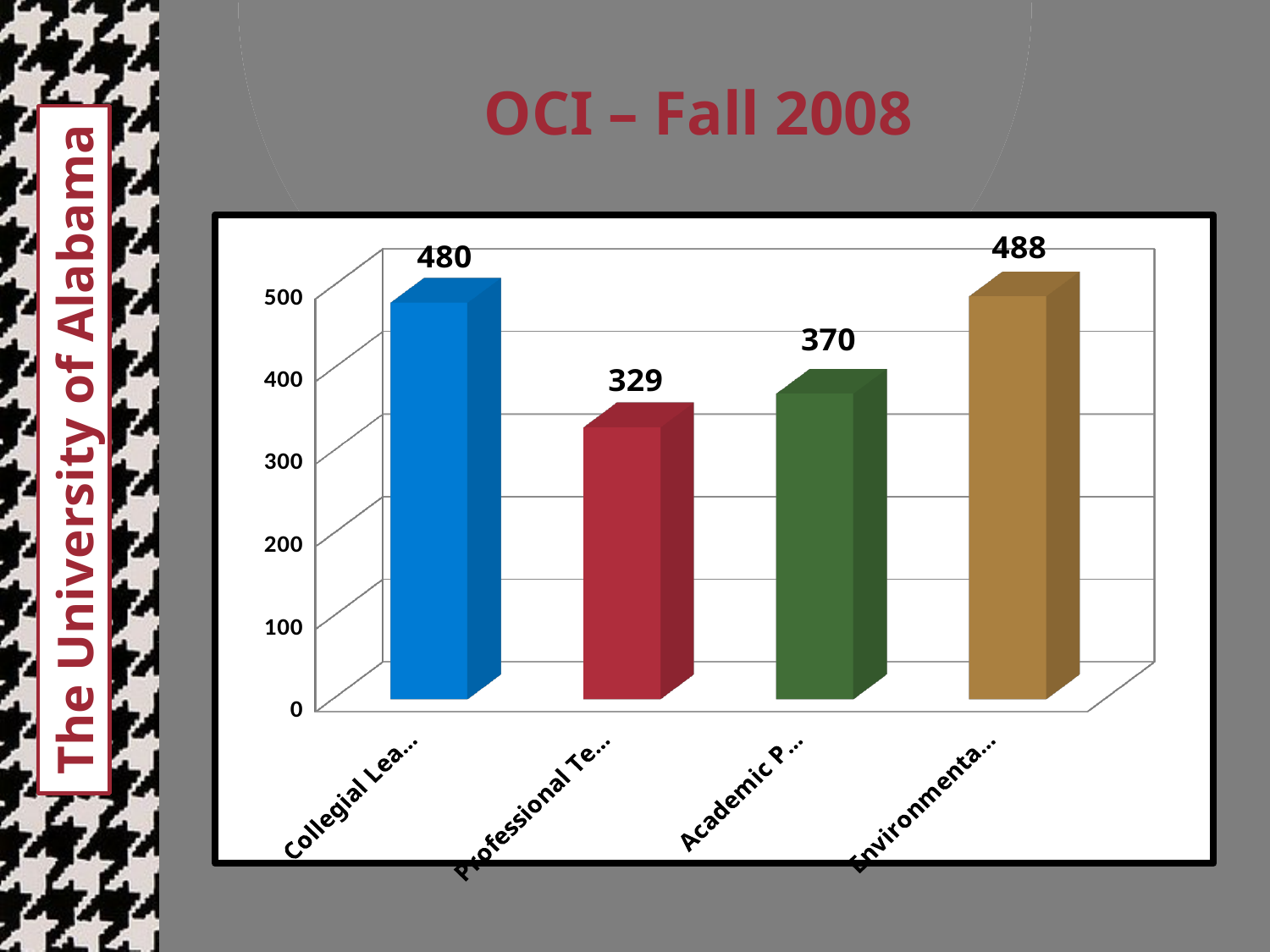
Which bar has the highest value? Environmenta... What is the value of the bar labelled "Academic P..."? 370 How many bars are shown in the chart? 4 What is the difference between the values of the "Environmenta..." bar and the "Collegial Lea..." bar? 8 Which is larger, the value for "Collegial Lea..." or the value for "Academic P..."? Collegial Lea... What is the difference between the values of the "Academic P..." bar and the "Professional Te..." bar? 41 What kind of chart is shown on the slide? Bar chart What is the value of the bar labelled "Professional Te..."? 329 Which bar has the lowest value? Professional Te... What is the value of the first bar, labelled "Collegial Lea..."? 480 What is the title of the slide containing the chart? OCI – Fall 2008 What is the value of the last bar, labelled "Environmenta..."? 488